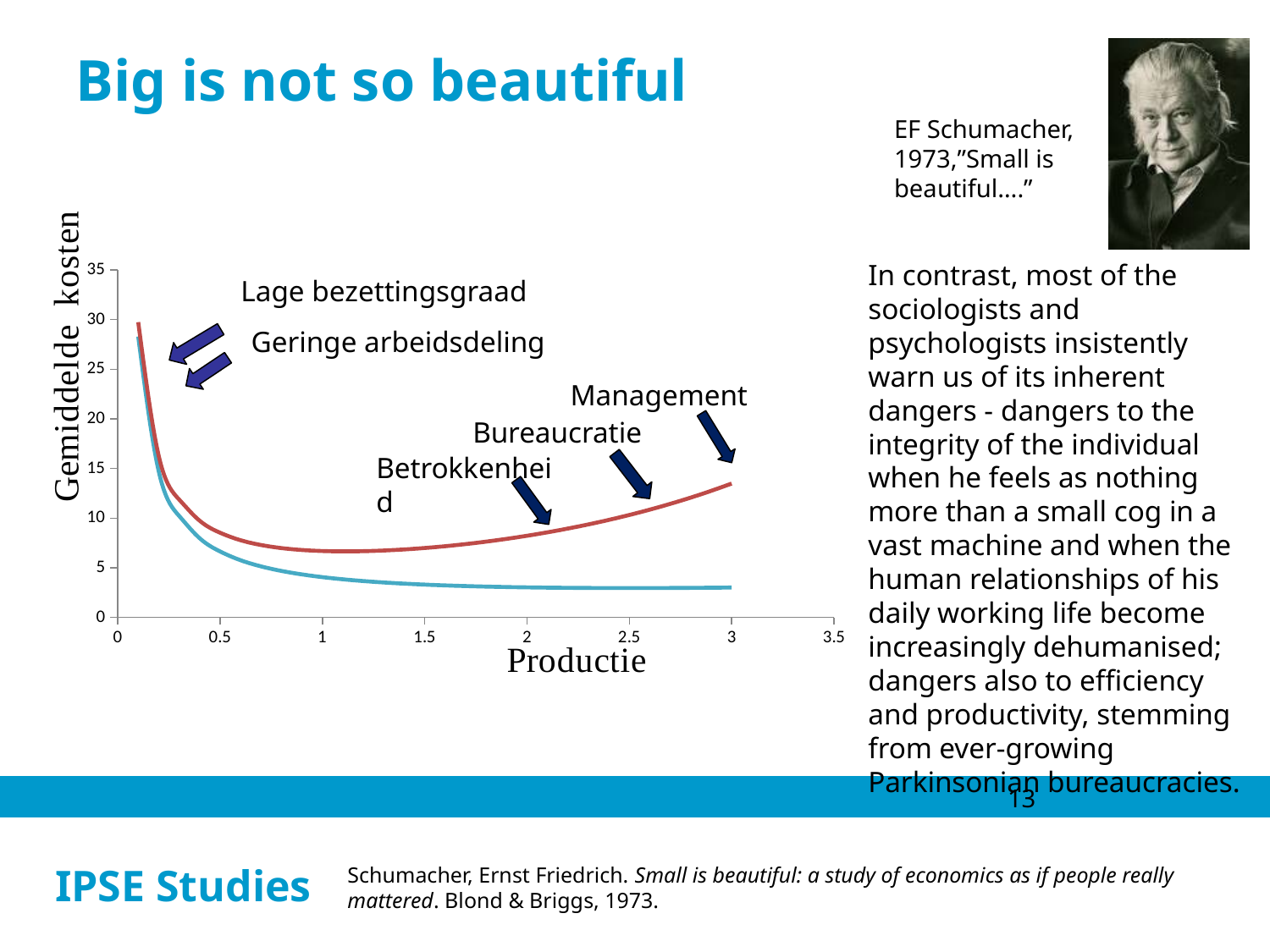
Is the value of the blue curve at Productie 0.5 greater or less than 15? less Is the value of the red curve at Productie 3 greater or less than 10? greater What kind of chart is shown on the slide? line chart Is the value of the red curve at Productie 1 greater or less than 10? less How many curves are plotted on the chart? 2 What is the title of the y axis of the chart? Gemiddelde kosten At Productie 3, which curve has the higher value, the red one or the blue one? the red one What is the title of the x axis of the chart? Productie What is the highest tick value shown on the y axis? 35 Does the red curve rise or fall between Productie 2 and Productie 3? rise Does the blue curve rise or fall as Productie increases? fall